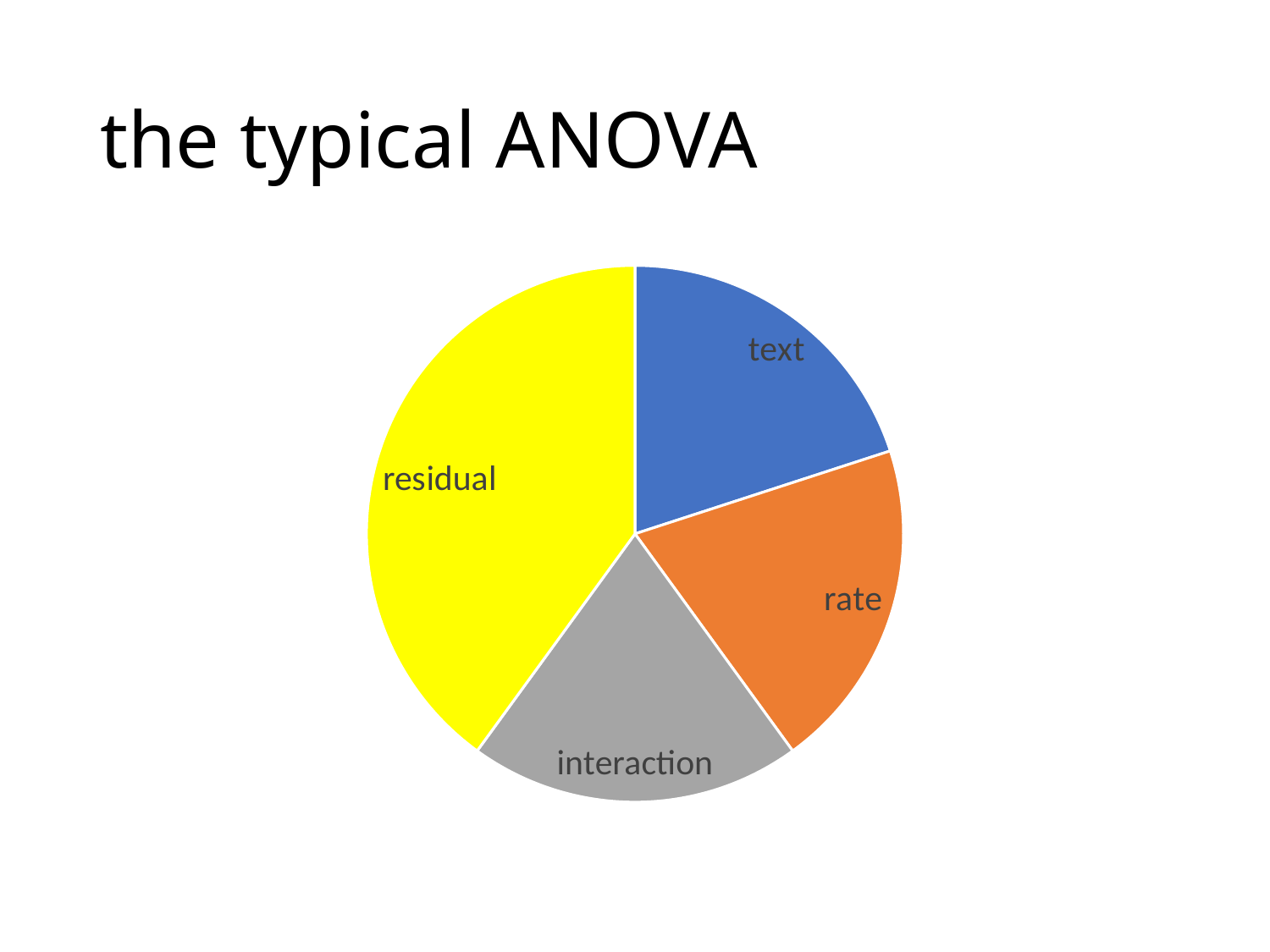
What kind of chart is shown on the slide? pie chart Which slice of the pie chart is the largest? residual What colour is the residual slice of the pie chart? yellow Which slice is larger, residual or interaction? residual Which slice of the pie chart is coloured blue? text How many slices does the pie chart have? 4 Which slice is larger, residual or text? residual Which slice is larger, residual or rate? residual